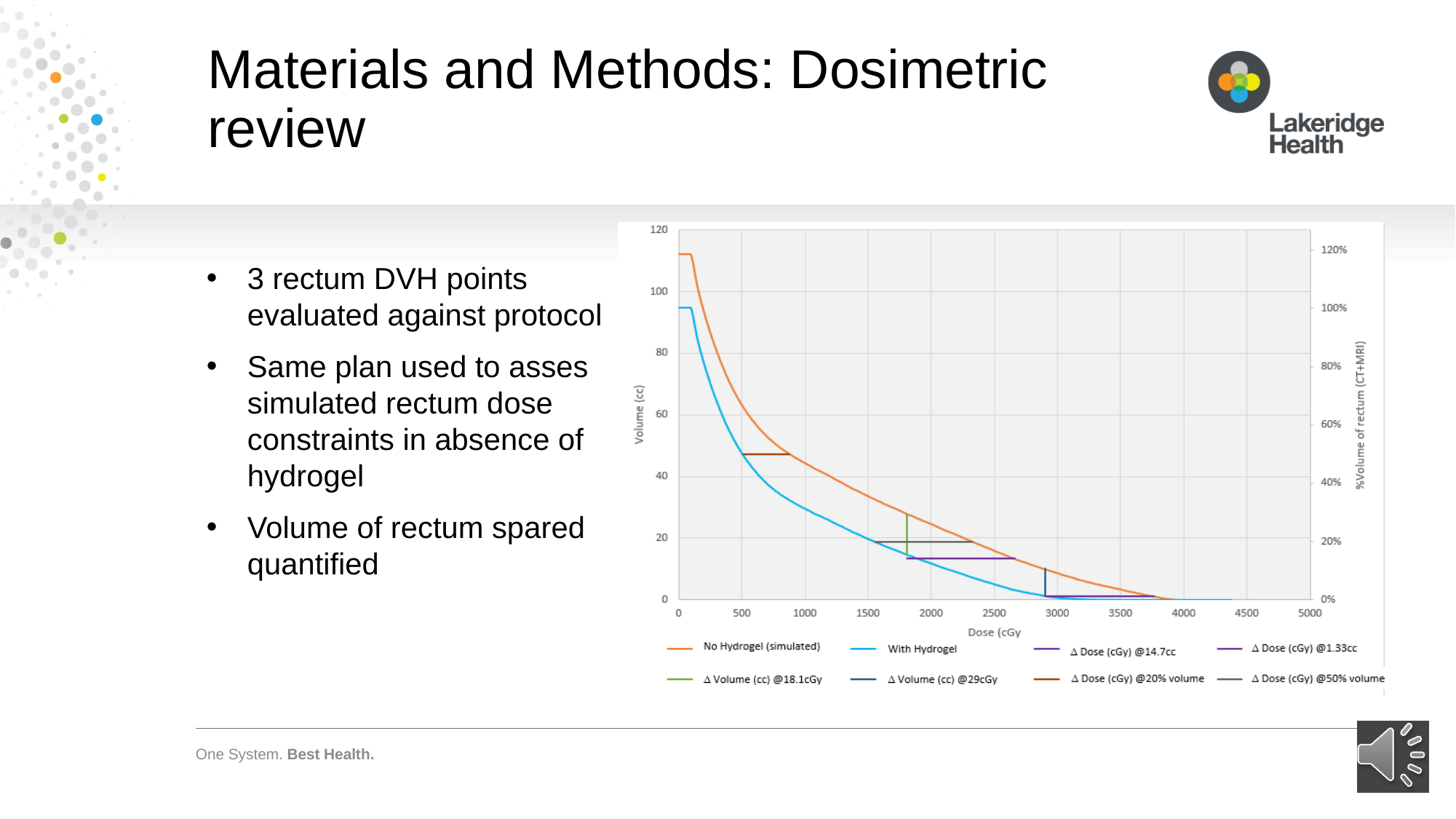
Is the With Hydrogel volume at 500 cGy greater or less than 60 cc? less Is the No Hydrogel (simulated) volume at 500 cGy greater or less than 40 cc? greater Is the With Hydrogel volume at 1000 cGy greater or less than 40 cc? less At 3000 cGy, which curve shows the larger volume: No Hydrogel (simulated) or With Hydrogel? No Hydrogel (simulated) How many series does the chart legend list? 8 What is the label of the horizontal axis of the chart? Dose (cGy) What kind of chart is shown on the slide? line chart What is the label of the left vertical axis of the chart? Volume (cc) At a dose of 1000 cGy, which curve shows the larger volume: No Hydrogel (simulated) or With Hydrogel? No Hydrogel (simulated) Do the No Hydrogel (simulated) and With Hydrogel curves rise or fall as dose increases along the x axis? fall